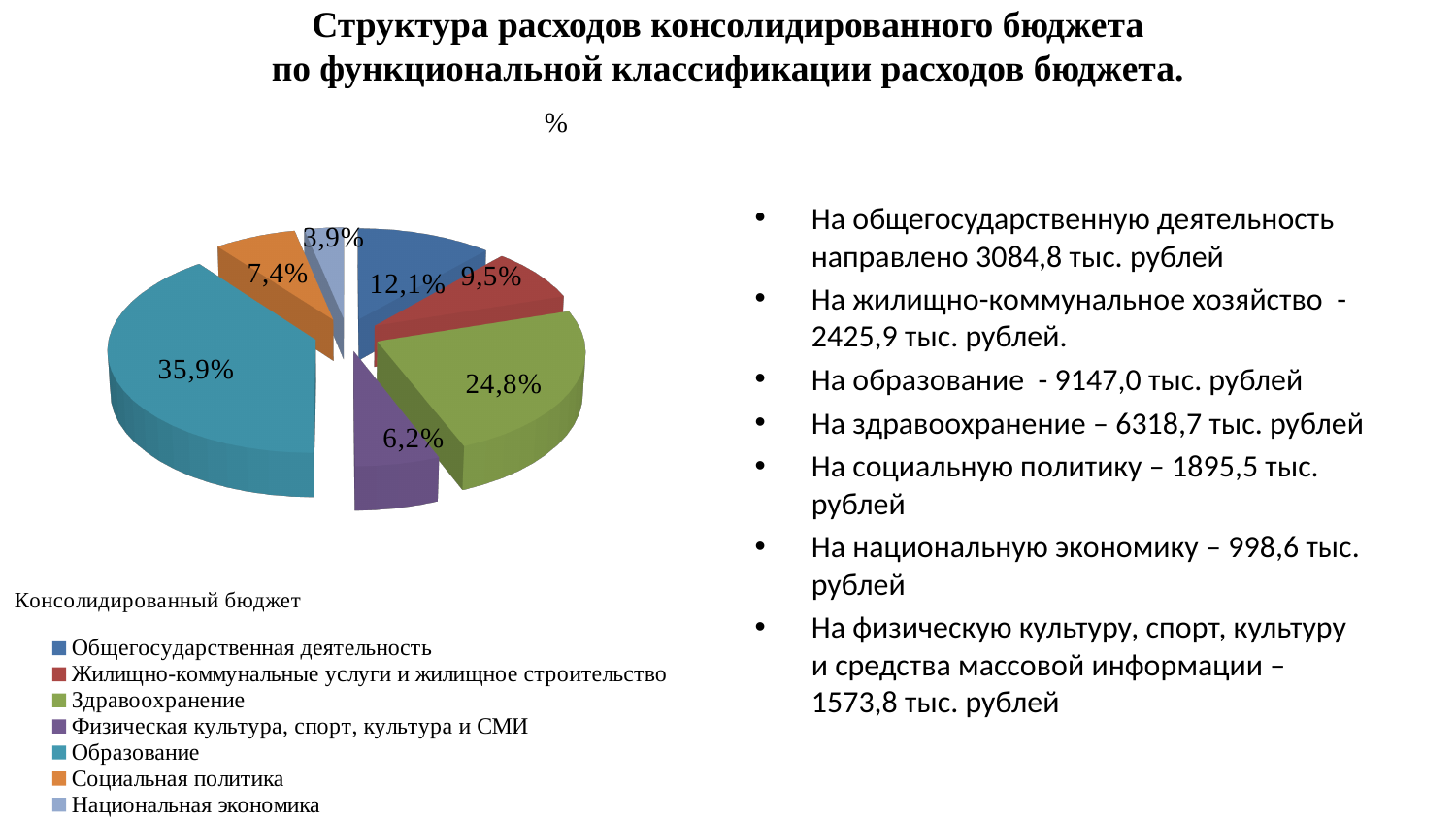
What colour is the slice for Здравоохранение? green Which is larger, the share for Жилищно-коммунальные услуги и жилищное строительство or the share for Физическая культура, спорт, культура и СМИ? Жилищно-коммунальные услуги и жилищное строительство What kind of chart is shown on the slide? pie chart How many categories does the legend list? 7 What share of the pie does Здравоохранение have? 24,8% What is the value shown for Национальная экономика? 3,9% Which category has the smallest slice of the pie? Национальная экономика Which category has the largest slice of the pie? Образование What is the difference between the shares of Образование and Здравоохранение? 11,1% What is the value shown for Социальная политика? 7,4% What is the value shown for Общегосударственная деятельность? 12,1% What share of the pie does Образование have? 35,9%